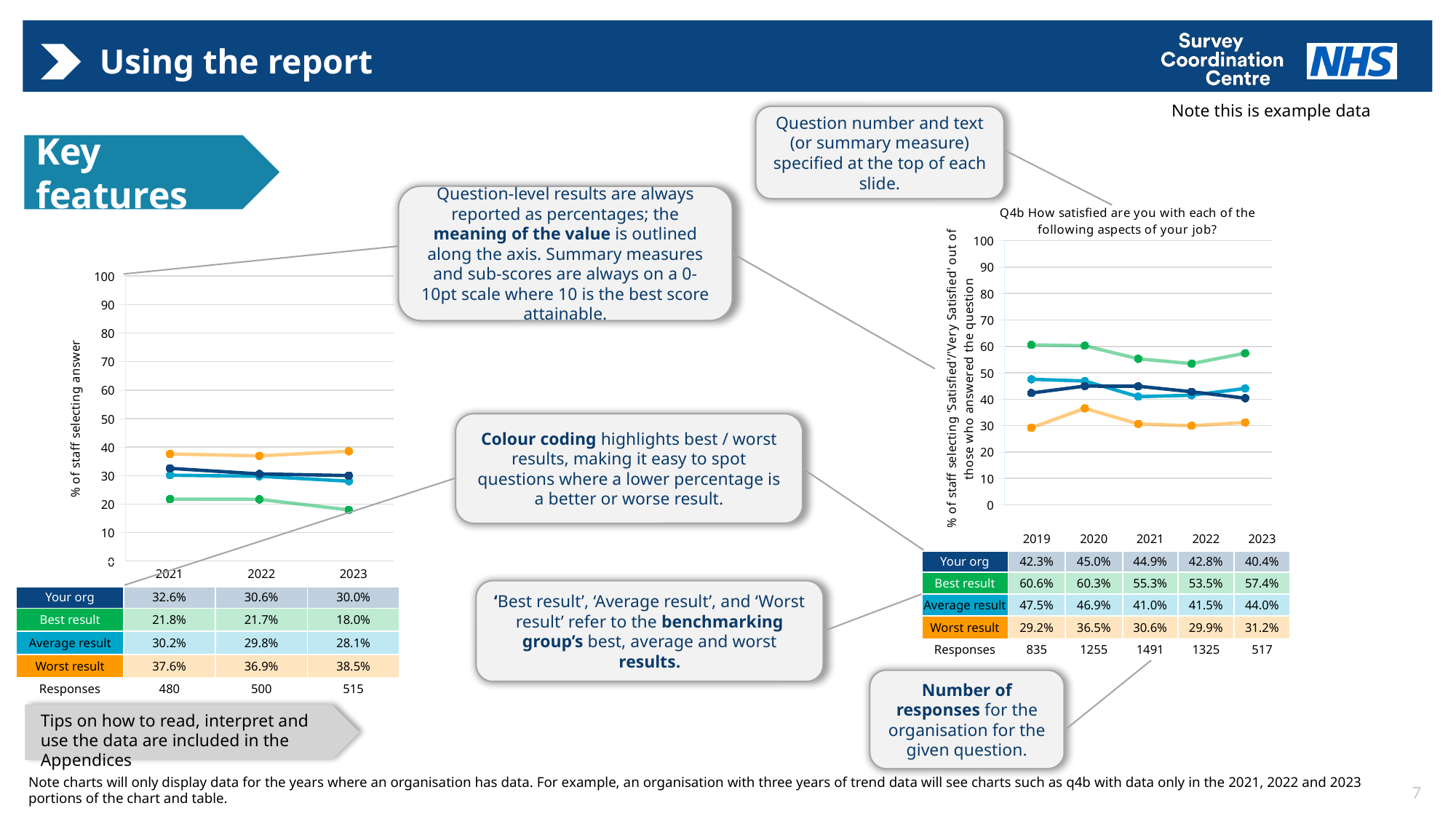
What type of chart is the Q4b chart on the right? Line chart On the Q4b chart on the right, what is the difference between the Best result and Your org values in 2019? 18.3% On the Q4b chart on the right, what is the value for Your org in 2021? 44.9% On the Q4b chart on the right, in which year is the Best result series lowest? 2022 On the left chart, how many series are shown in the table below the chart (excluding Responses)? 4 On the Q4b chart on the right, in which year is the Worst result series highest? 2020 On the left chart, what is the Worst result value for 2023? 38.5% On the Q4b chart on the right, how many years are plotted on the x axis? 5 On the left chart, does the Best result series rise or fall from 2021 to 2023? Fall On the left chart, what is the Average result value for 2022? 29.8% On the left chart, which is larger in 2021: Your org or Average result? Your org On the Q4b chart on the right, what is the Best result value in 2023? 57.4%